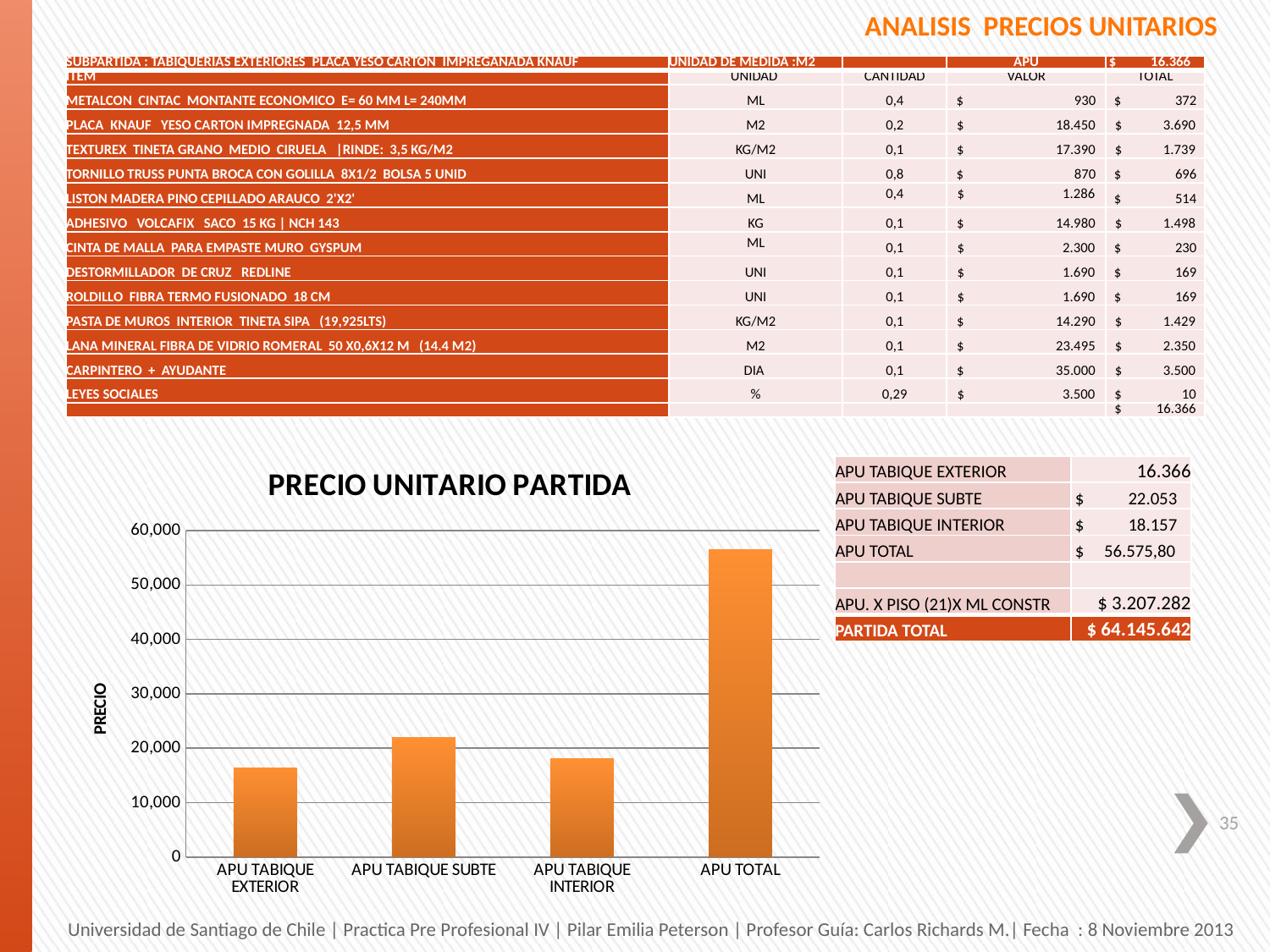
What is the label on the vertical axis of the chart? PRECIO How many categories are plotted in the chart? 4 Is the value for APU TABIQUE EXTERIOR greater or less than 20,000? less Is the value for APU TOTAL greater or less than 60,000? less What kind of chart is shown on the slide? bar chart Is the value for APU TABIQUE EXTERIOR greater or less than 10,000? greater Which is larger, the value for APU TABIQUE SUBTE or the value for APU TABIQUE INTERIOR? APU TABIQUE SUBTE Which category has the highest value in the chart? APU TOTAL What is the title of the chart? PRECIO UNITARIO PARTIDA